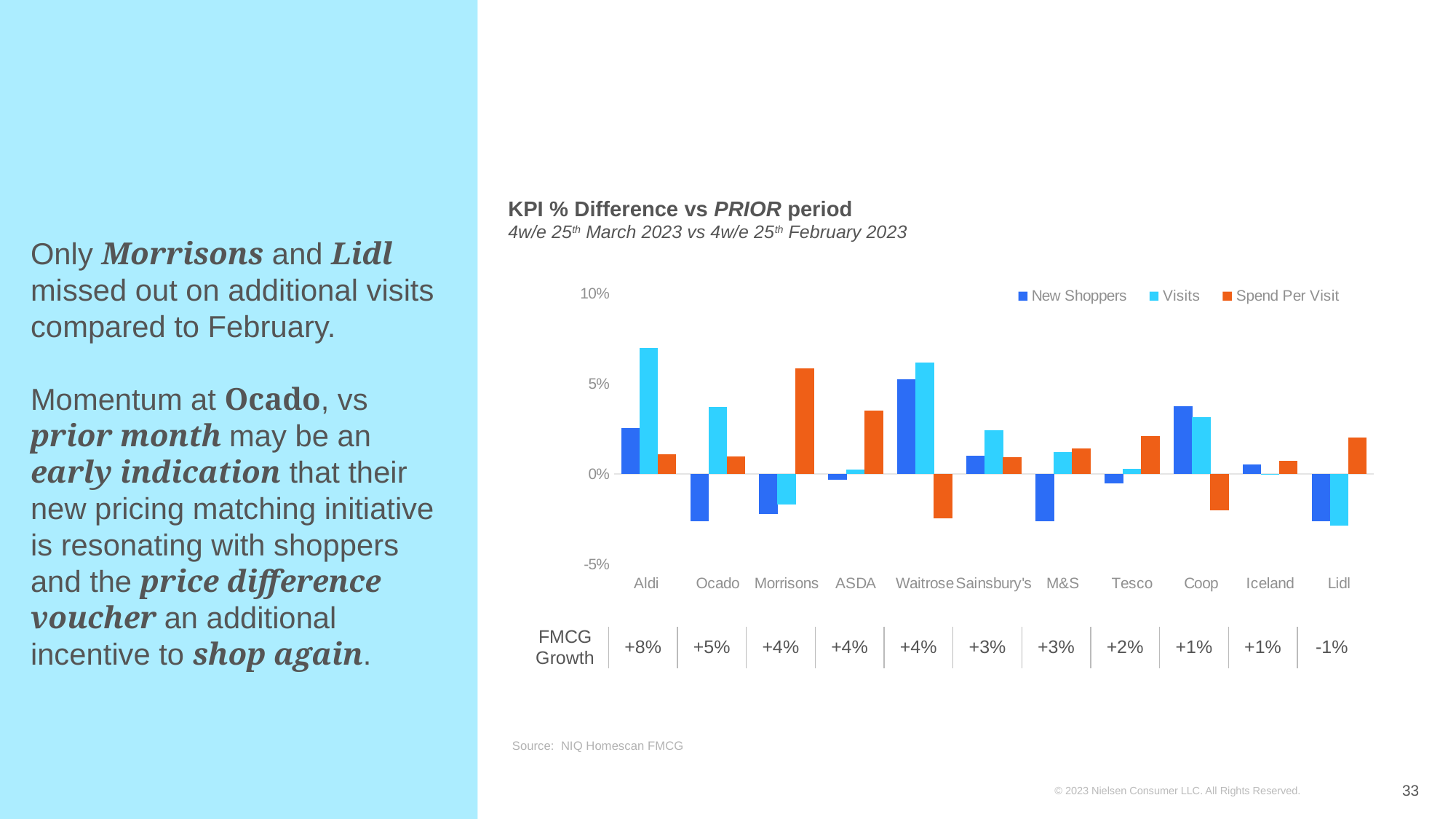
What is the FMCG Growth value shown for Aldi? +8% What kind of chart is shown on the slide? Bar chart Which retailer has the highest Spend Per Visit bar? Morrisons Which retailer has the lowest FMCG Growth value in the table below the chart? Lidl What colour represents the Spend Per Visit series in the chart legend? Orange How many series does the chart legend list? 3 Is the New Shoppers value for Ocado greater or less than 0%? less What is the difference between the FMCG Growth values for Aldi and Lidl? 9 percentage points Which is larger, the Spend Per Visit bar for Morrisons or for Aldi? Morrisons How many retailers are shown along the x axis of the chart? 11 What is the FMCG Growth value shown for Lidl? -1% Is the Visits value for Aldi greater or less than 5%? greater